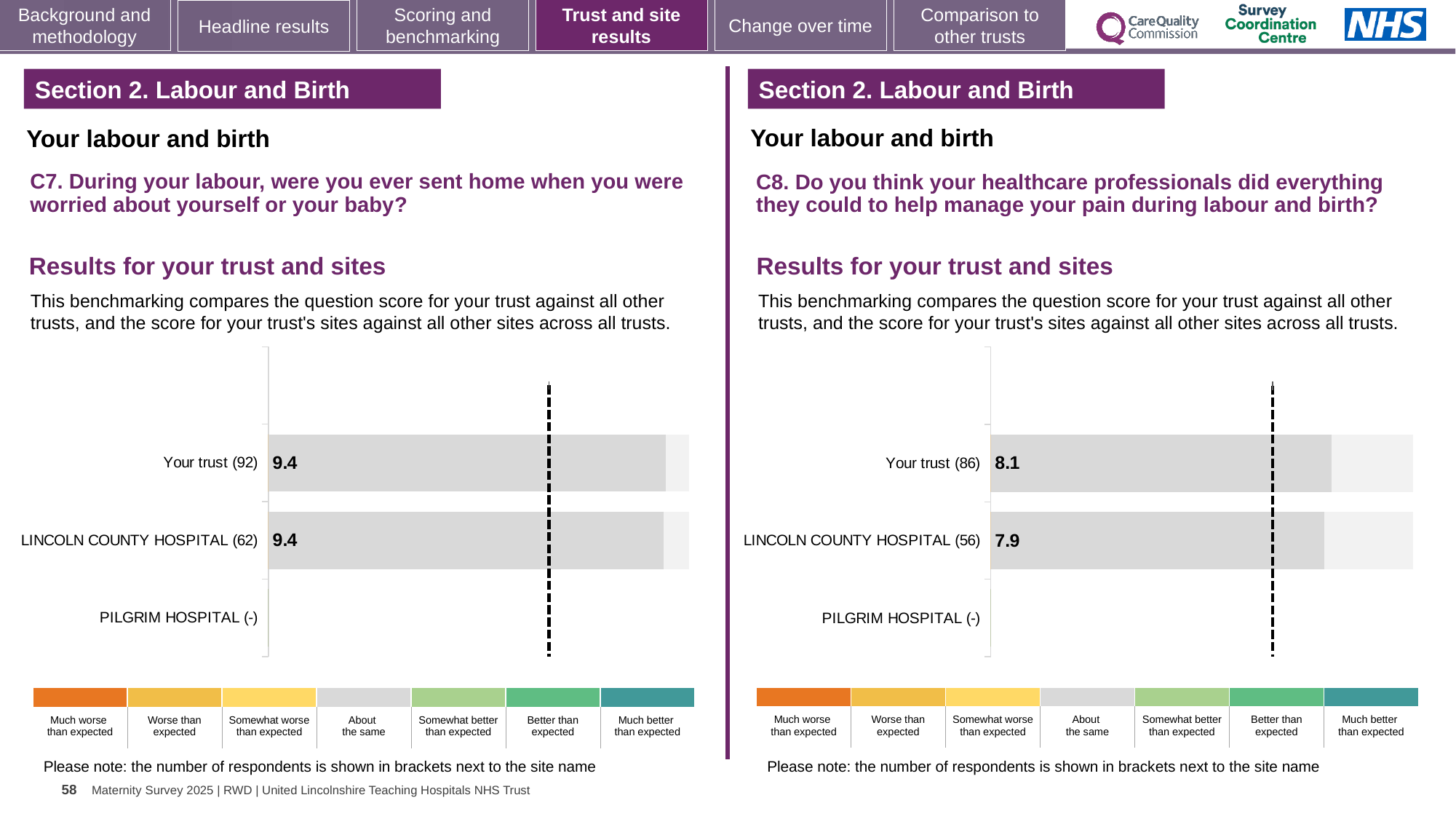
How many categories does the colour legend below the C8 chart on the right list? 7 In the C8 chart on the right, what is the difference between the score for Your trust and the score for LINCOLN COUNTY HOSPITAL? 0.2 In the C7 chart on the left, what is the score for Your trust? 9.4 In the C8 chart on the right, how many respondents are shown in brackets for LINCOLN COUNTY HOSPITAL? 56 In the C8 chart on the right, which has the higher score, Your trust or LINCOLN COUNTY HOSPITAL? Your trust In the C7 chart on the left, which site has no score shown? PILGRIM HOSPITAL What kind of chart is the C8 chart on the right? Bar chart In the C8 chart on the right, what is the score for Your trust? 8.1 In the C7 chart on the left, how many respondents are shown in brackets for Your trust? 92 In the C7 chart on the left, what is the score for LINCOLN COUNTY HOSPITAL? 9.4 In the C8 chart on the right, what is the score for LINCOLN COUNTY HOSPITAL? 7.9 How many categories are listed on the vertical axis of the C7 chart on the left? 3